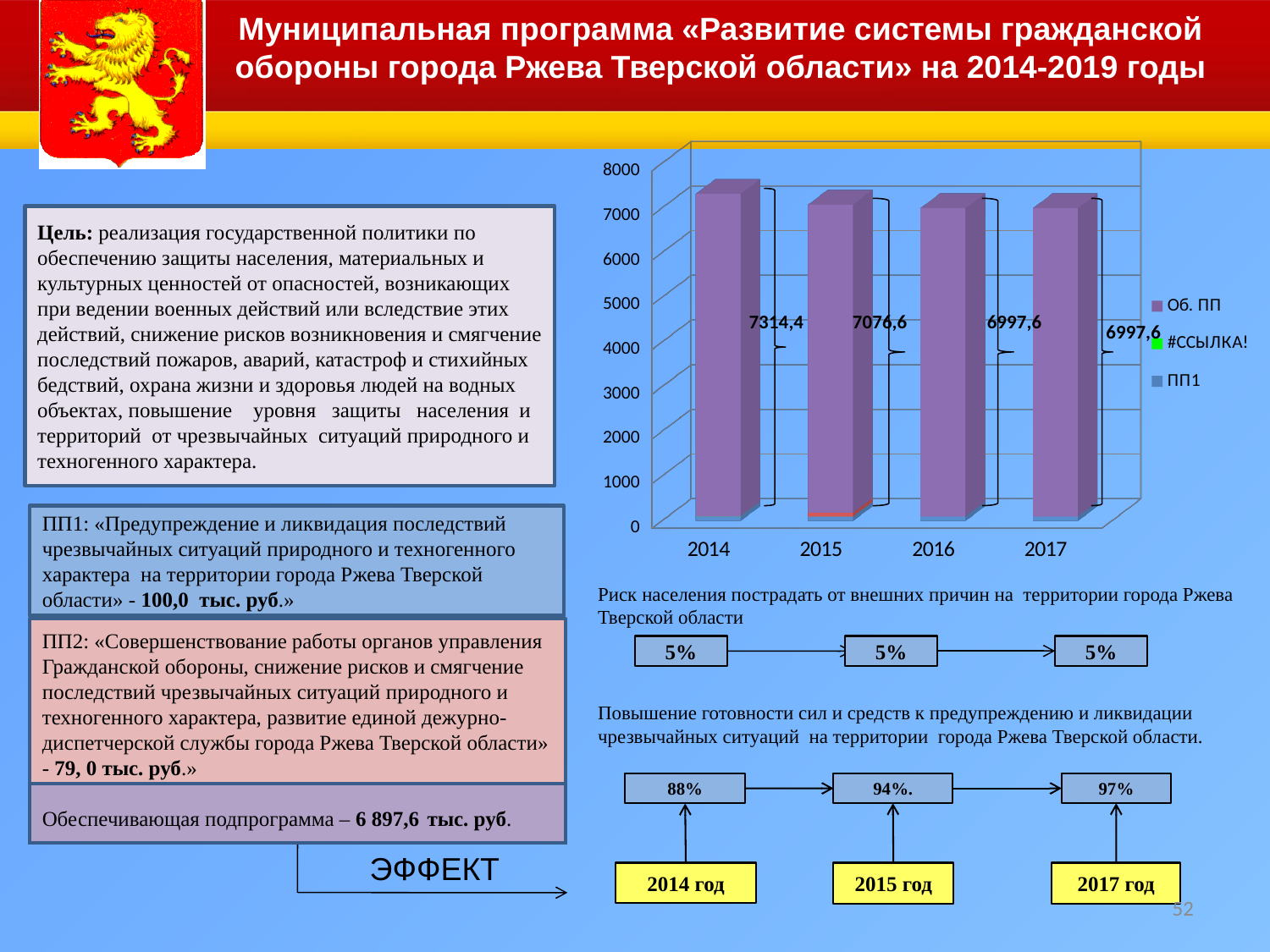
Which is larger, the labelled value for 2014 or for 2015? 2014 What value is labelled on the bar for 2014? 7314,4 How many years are shown on the x axis of the chart? 4 What value is labelled on the bar for 2017? 6997,6 What value is labelled on the bar for 2016? 6997,6 What is the difference between the labelled values for 2015 and 2016? 79,0 How many series does the chart legend list? 3 What kind of chart is shown on the slide? bar chart What value is labelled on the bar for 2015? 7076,6 Which year has the highest labelled value? 2014 What is the difference between the labelled values for 2014 and 2015? 237,8 Is the value for 2014 greater or less than 7000? greater